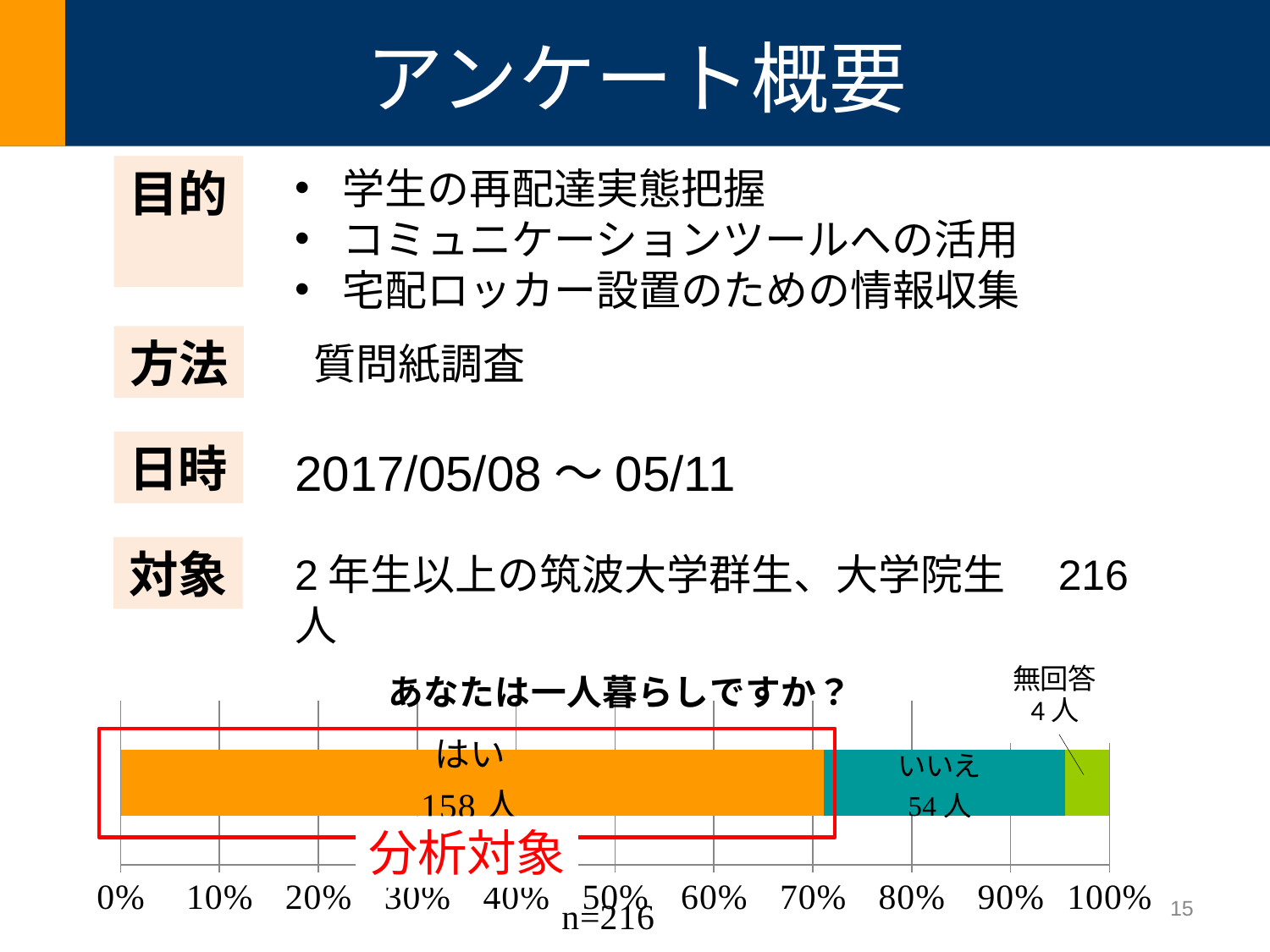
What is the title of the chart? あなたは一人暮らしですか？ How many people gave 無回答 (no answer)? 4 人 How many people answered はい? 158 人 Is the share of はい responses greater or less than 70%? greater What is the total number of respondents across all segments of the bar? 216 Which response category has the smallest number of people? 無回答 How many people answered いいえ? 54 人 Which response category has the largest number of people? はい Which is larger, the number of いいえ responses or the number of 無回答 responses? いいえ What kind of chart is shown on the slide? bar chart How many response categories are shown in the stacked bar? 3 How many more people answered はい than いいえ? 104 人